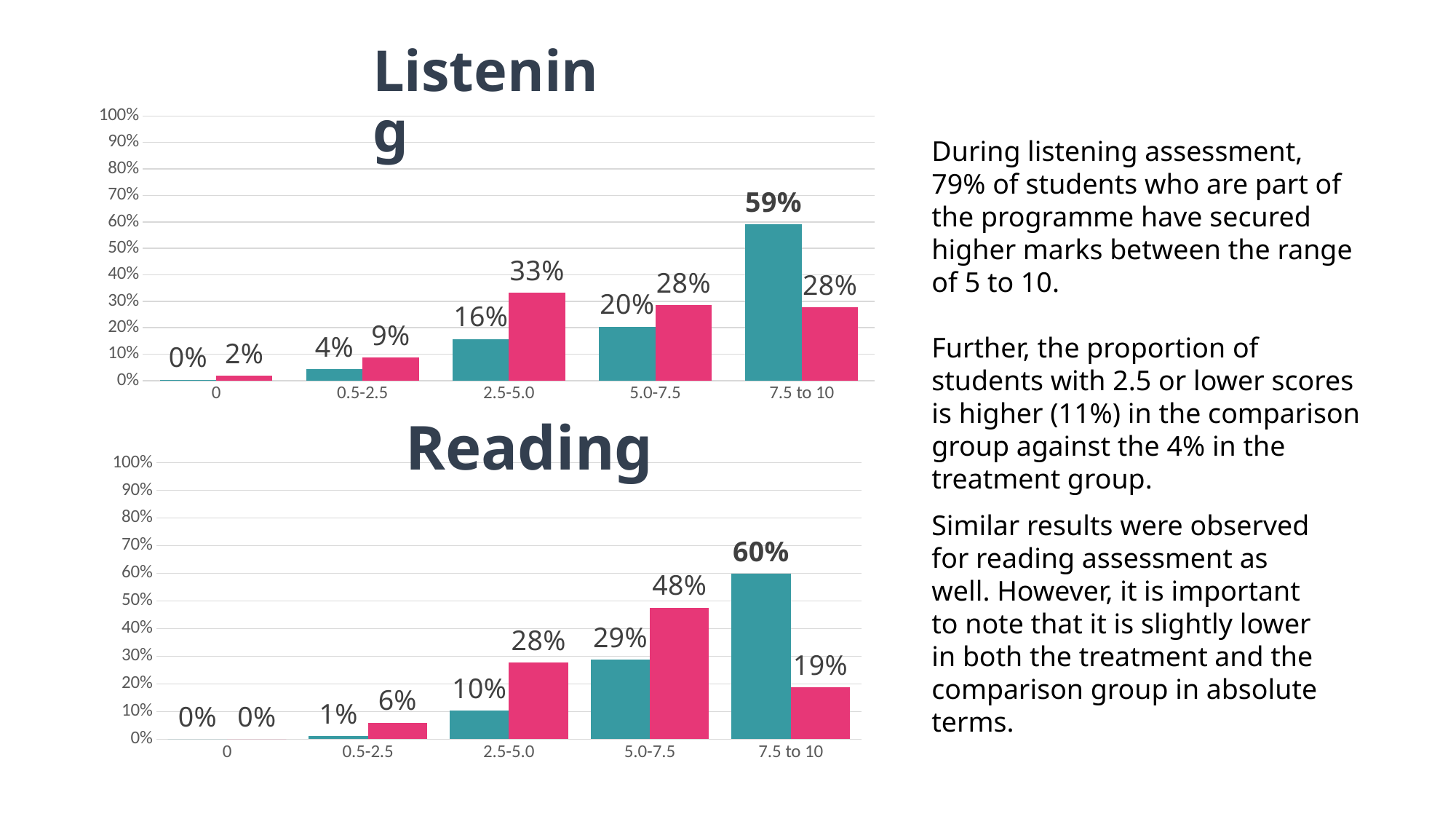
In the Reading chart, what is the difference between the pink and teal bars for the 2.5-5.0 category? 18% In the Reading chart, which category has the highest pink bar? 5.0-7.5 How many categories are shown on the x axis of the Reading chart? 5 In the Listening chart, what is the value of the pink bar for the 2.5-5.0 category? 33% In the Reading chart, what is the value of the pink bar for the 5.0-7.5 category? 48% In the Listening chart, what is the difference between the teal and pink bars for the 7.5 to 10 category? 31% In the Listening chart, what is the value of the teal bar for the 7.5 to 10 category? 59% In the Reading chart, what is the value of the teal bar for the 0.5-2.5 category? 1% In the Listening chart, which is larger for the 5.0-7.5 category, the teal bar or the pink bar? the pink bar What type of chart is the Listening chart? bar chart In the Listening chart, which category has the highest teal bar? 7.5 to 10 In the Reading chart, do the teal bars rise or fall from the 0 category to the 7.5 to 10 category? rise